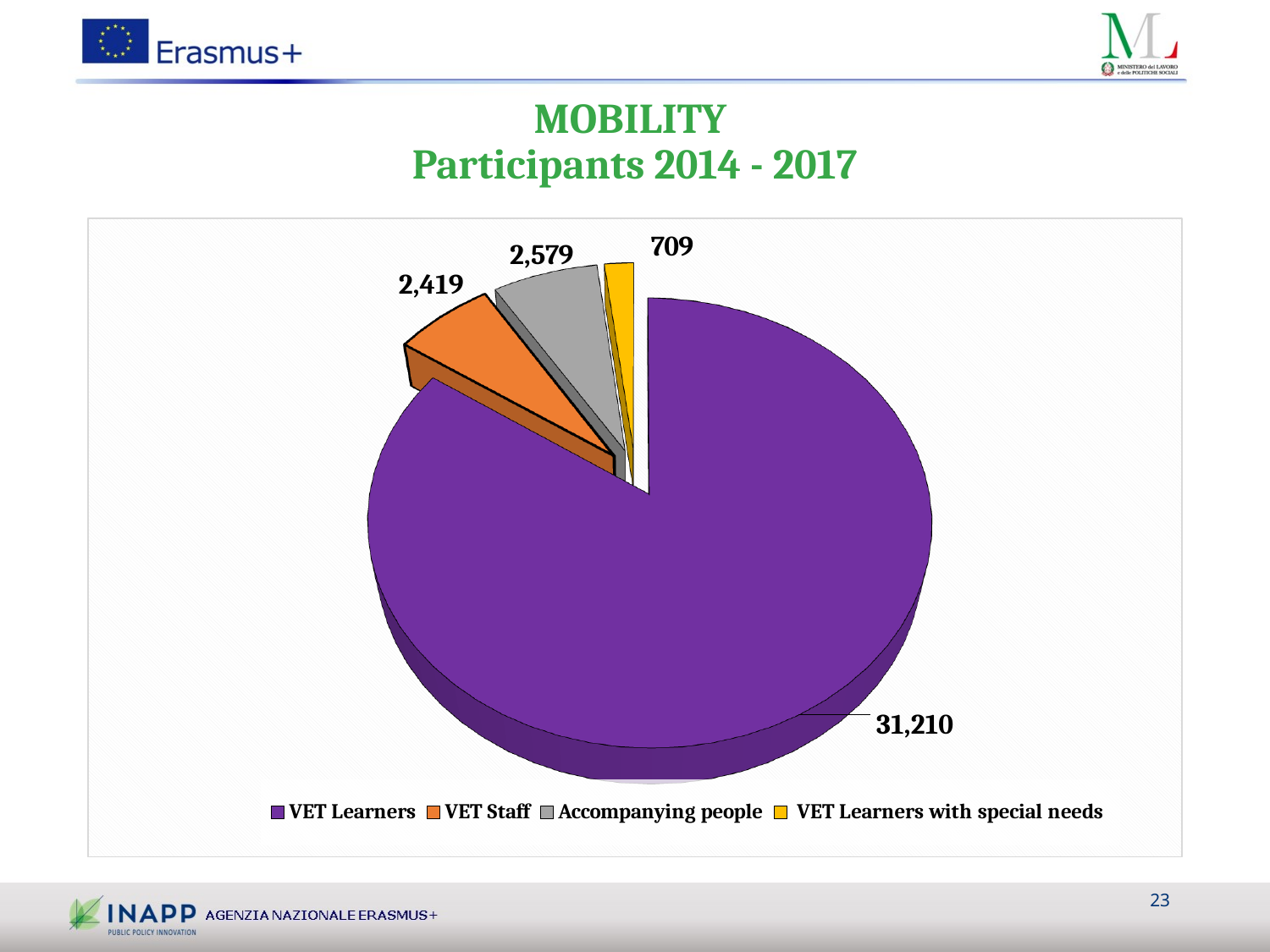
How many participants were VET Learners? 31,210 Which is larger, the number of VET Staff or the number of Accompanying people? Accompanying people Which category has the smallest number of participants? VET Learners with special needs How many participants were VET Staff? 2,419 How many participants were VET Learners with special needs? 709 How many categories does the pie chart show? 4 What is the difference between the number of Accompanying people and the number of VET Staff? 160 How many participants were Accompanying people? 2,579 What is the total number of participants across all four categories? 36,917 What is the title of the chart on the slide? MOBILITY Participants 2014 - 2017 Which category has the largest number of participants? VET Learners What kind of chart is shown on the slide? Pie chart